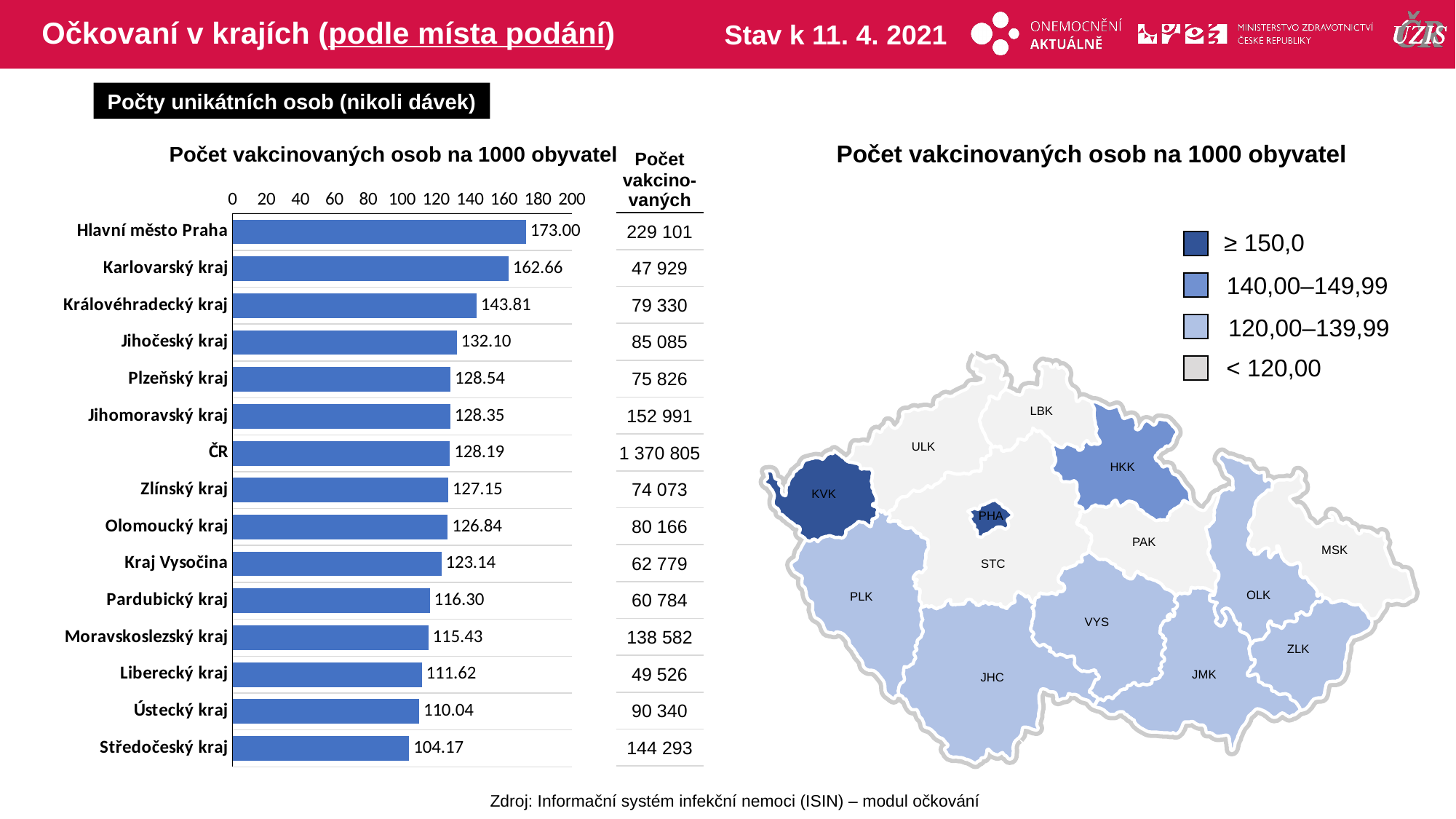
In the bar chart 'Počet vakcinovaných osob na 1000 obyvatel', what is the difference between the values for Hlavní město Praha and Středočeský kraj? 68.83 How many categories (bars) are shown in the bar chart 'Počet vakcinovaných osob na 1000 obyvatel'? 15 In the bar chart 'Počet vakcinovaných osob na 1000 obyvatel', what is the value for Hlavní město Praha? 173.00 In the bar chart 'Počet vakcinovaných osob na 1000 obyvatel', which category has the lowest value? Středočeský kraj In the bar chart 'Počet vakcinovaných osob na 1000 obyvatel', what is the difference between the values for Hlavní město Praha and Karlovarský kraj? 10.34 In the bar chart 'Počet vakcinovaných osob na 1000 obyvatel', which has a larger value, Liberecký kraj or Pardubický kraj? Pardubický kraj What kind of chart is the left-hand chart 'Počet vakcinovaných osob na 1000 obyvatel'? bar chart In the bar chart 'Počet vakcinovaných osob na 1000 obyvatel', what is the value for Jihočeský kraj? 132.10 In the bar chart 'Počet vakcinovaných osob na 1000 obyvatel', is the value for Karlovarský kraj greater or less than 160? greater In the bar chart 'Počet vakcinovaných osob na 1000 obyvatel', which category has the highest value? Hlavní město Praha In the bar chart 'Počet vakcinovaných osob na 1000 obyvatel', what is the value for ČR? 128.19 How many value classes does the legend of the map 'Počet vakcinovaných osob na 1000 obyvatel' list? 4